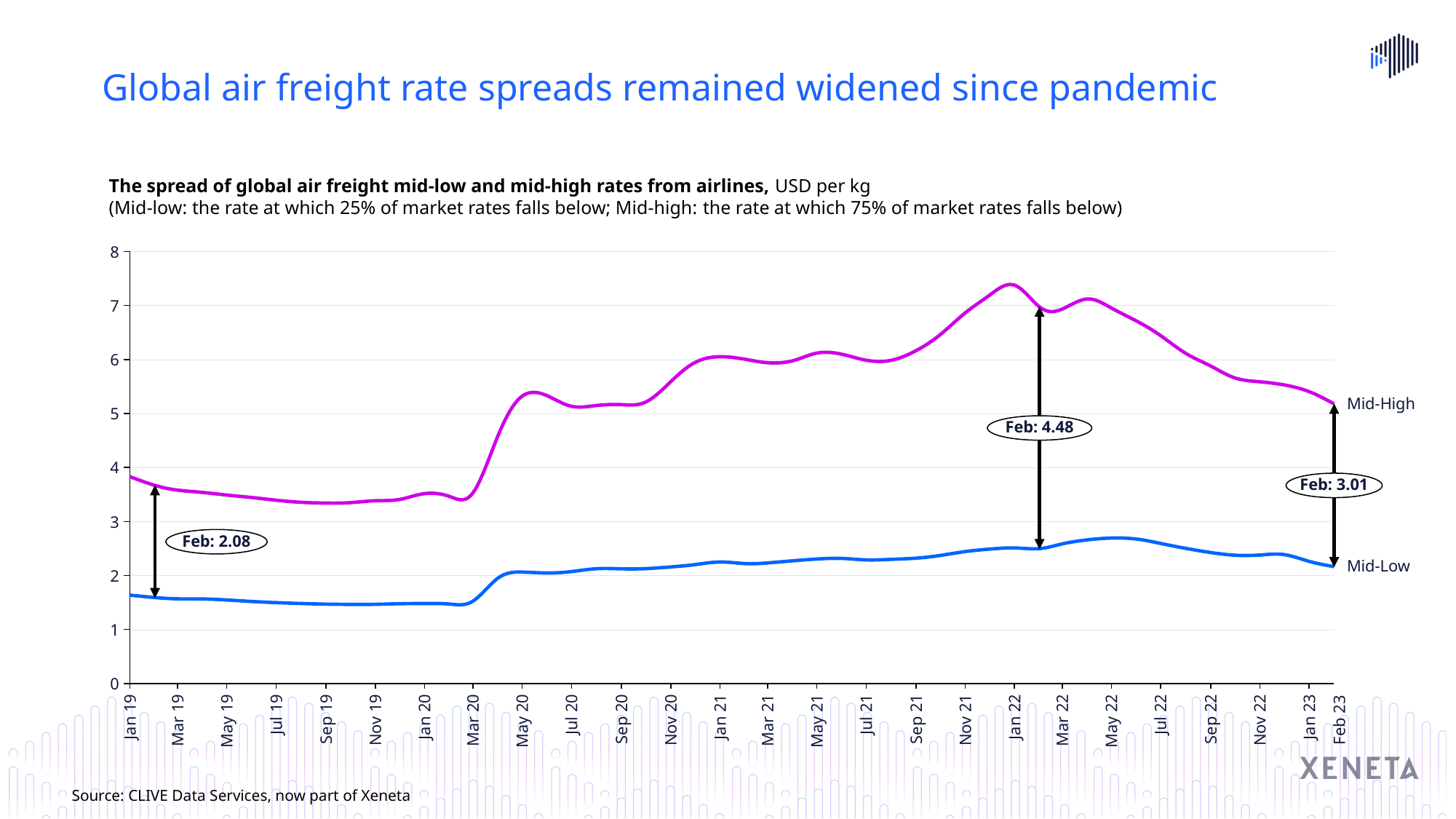
In what unit are the rates on the chart expressed? USD per kg What kind of chart is shown on the slide? line chart What is the annotated spread between mid-high and mid-low rates for Feb 2022? 4.48 Is the Mid-Low value in Jan 19 greater or less than 2? less Of the three annotated February spreads, which year has the largest spread? Feb 2022 Of the three annotated February spreads, which year has the smallest spread? Feb 2019 What is the annotated spread between mid-high and mid-low rates for Feb 2019? 2.08 What is the annotated spread between mid-high and mid-low rates for Feb 2023? 3.01 Is the Mid-High value in Jan 22 greater or less than 7? greater How many series are plotted on the chart? 2 Does the Mid-High line rise or fall between May 22 and Feb 23? fall By how much is the annotated Feb 2022 spread larger than the annotated Feb 2019 spread? 2.40